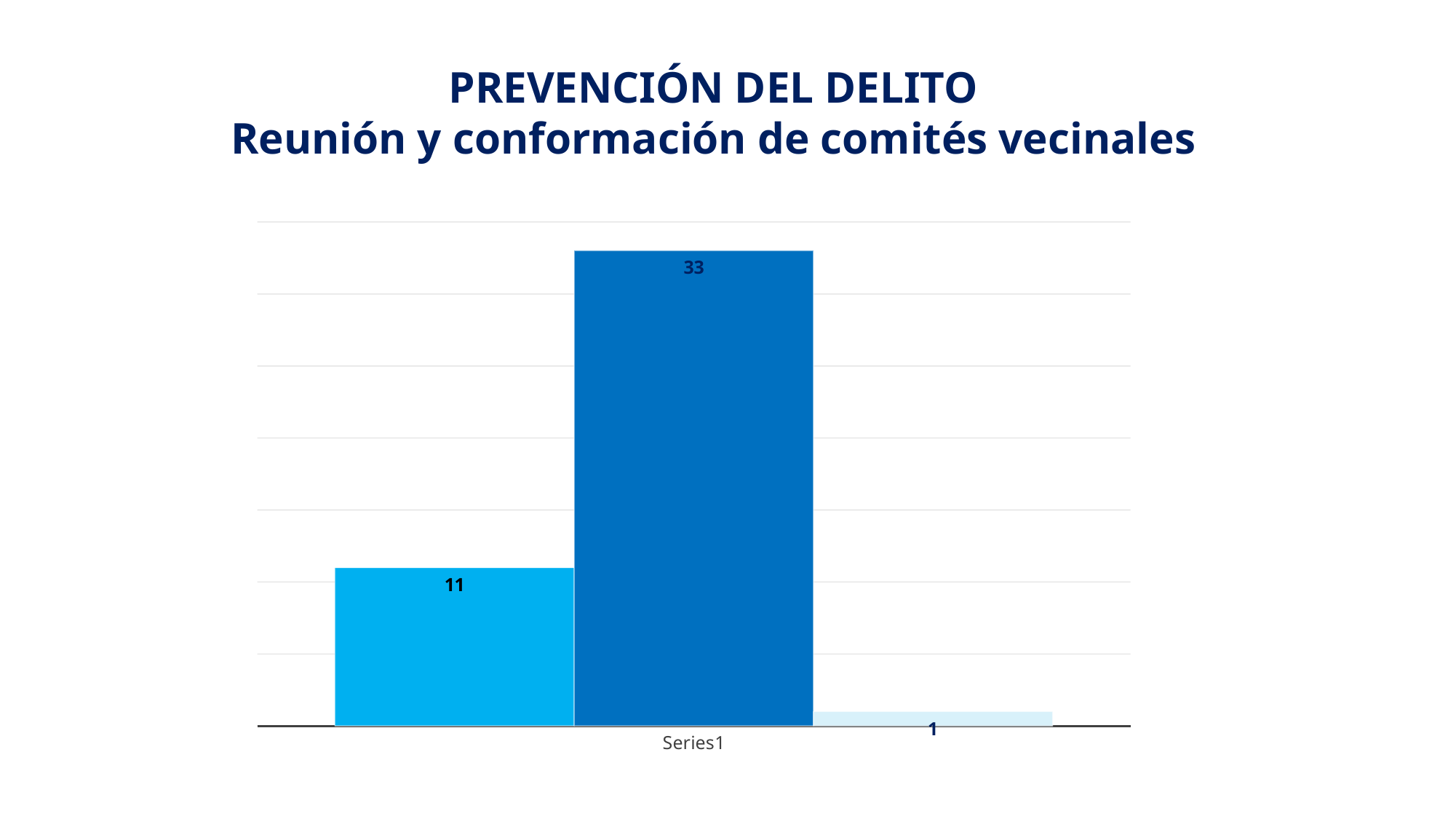
What is the value of the middle (dark blue) bar? 33 How many bars are plotted in the chart? 3 What is the value of the rightmost (pale blue) bar? 1 What label appears on the x axis below the bars? Series1 What is the value shown on the tallest bar? 33 Which is larger, the leftmost bar or the middle bar? the middle bar What type of chart is shown on the slide? bar chart What is the difference between the leftmost bar (11) and the rightmost bar (1)? 10 What is the total of the three bar values shown? 45 What is the value of the leftmost (light blue) bar? 11 What is the difference between the middle bar (33) and the leftmost bar (11)? 22 What is the value shown on the shortest bar? 1